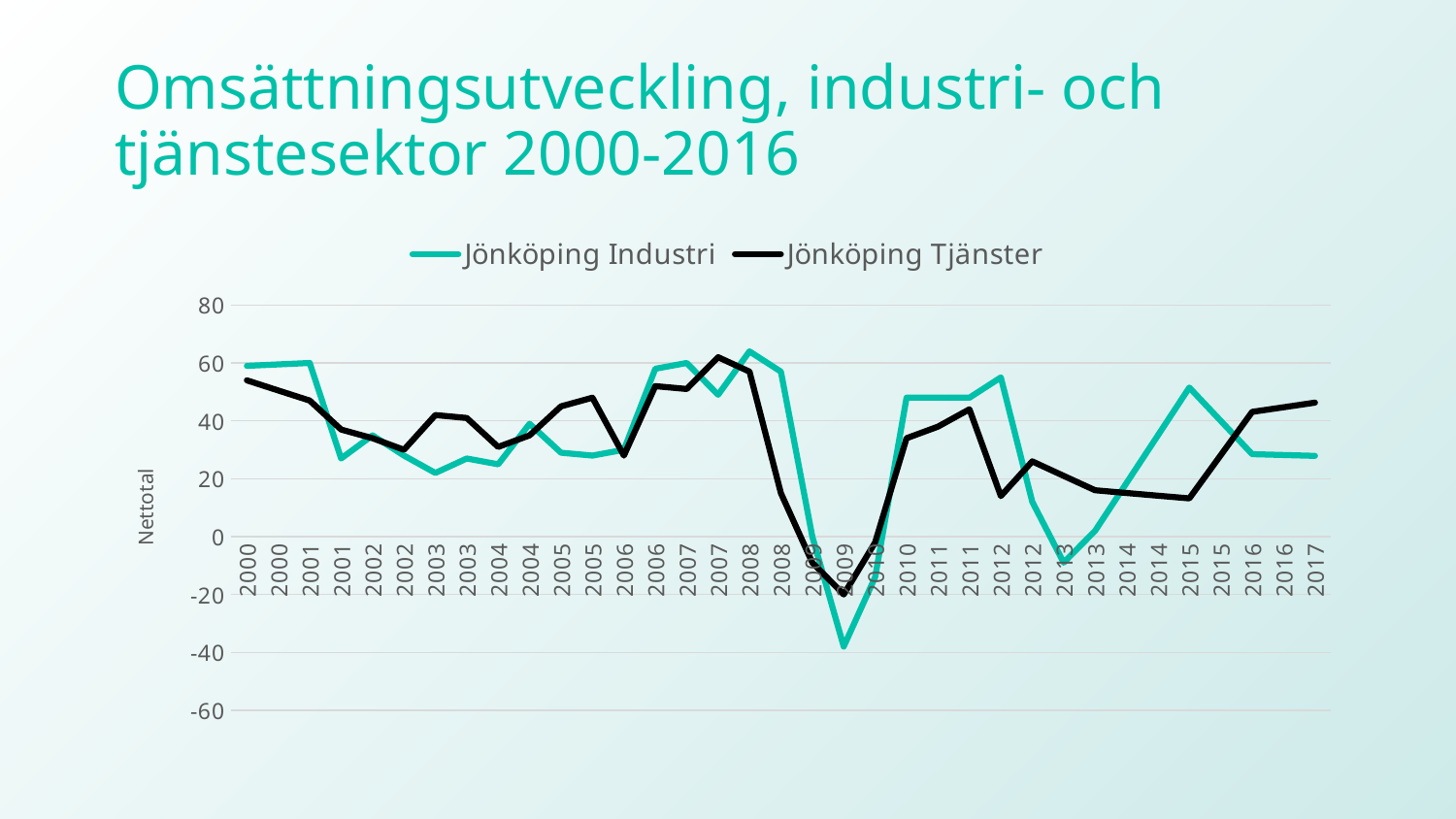
At 2017, which series has the higher value, Jönköping Industri or Jönköping Tjänster? Jönköping Tjänster What type of chart is shown on the slide? Line chart Is the value for Jönköping Industri at 2017 greater or less than 40? less At the first 2015 point, which series has the higher value, Jönköping Industri or Jönköping Tjänster? Jönköping Industri Is the value for Jönköping Industri at the first 2000 point greater or less than 40? greater Is the value for Jönköping Tjänster at 2017 greater or less than 40? greater Do both series rise or fall between 2008 and 2009? fall Around which year does the Jönköping Industri series reach its lowest value? 2009 How many series does the legend list? 2 What is the label on the vertical axis? Nettotal What are the two series named in the legend? Jönköping Industri and Jönköping Tjänster